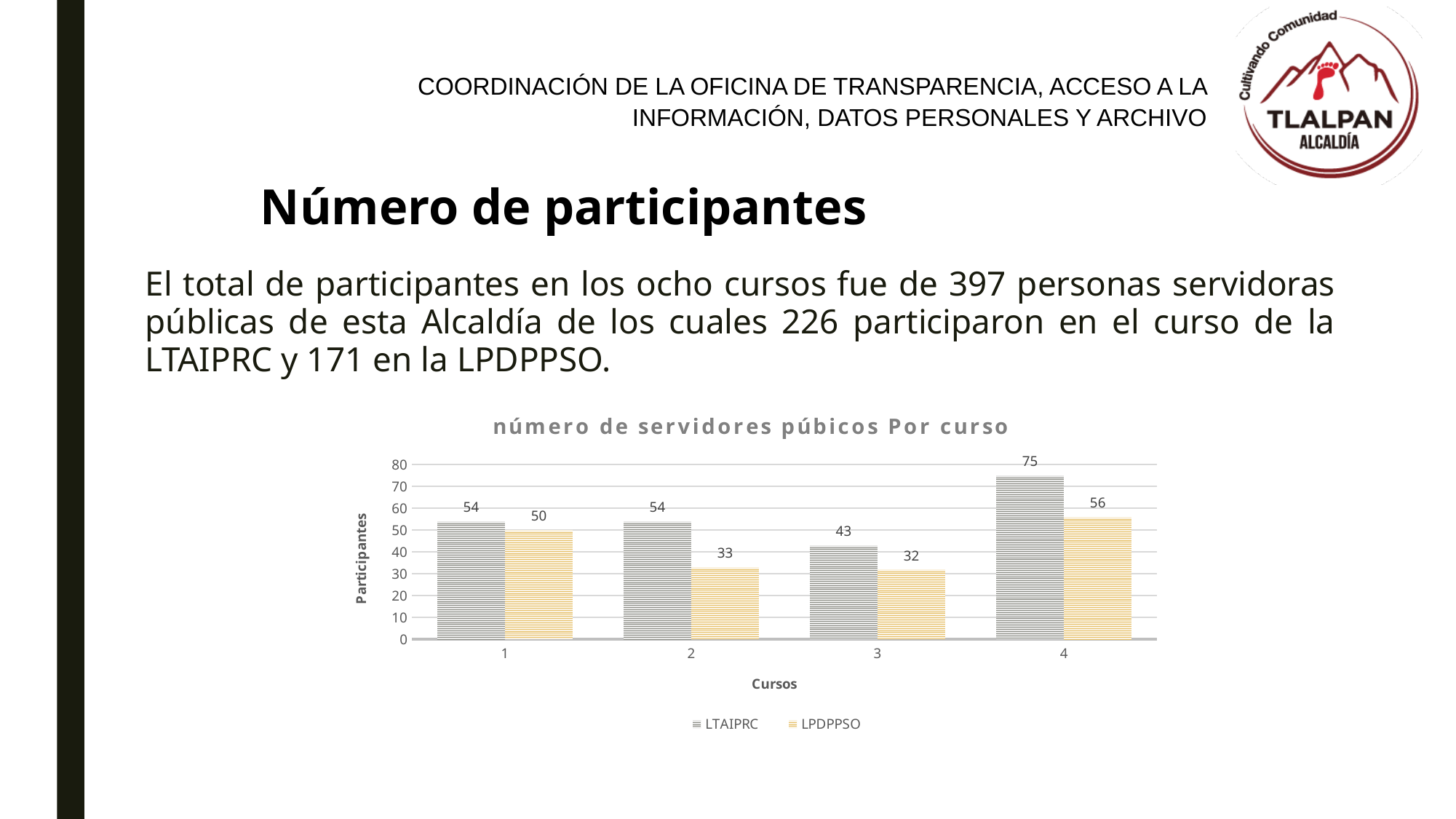
How many courses are shown on the x axis? 4 Which course has the highest LTAIPRC value? 4 What is the difference between the LTAIPRC and LPDPPSO values for course 2? 21 What kind of chart is shown on the slide? bar chart How many series does the legend list? 2 Is the LTAIPRC value for course 4 greater or less than 70? greater What is the LPDPPSO value for course 4? 56 What is the LPDPPSO value for course 3? 32 Which course has the lowest LPDPPSO value? 3 For course 3, which series has the larger value, LTAIPRC or LPDPPSO? LTAIPRC What is the LTAIPRC value for course 1? 54 What is the label of the y axis? Participantes